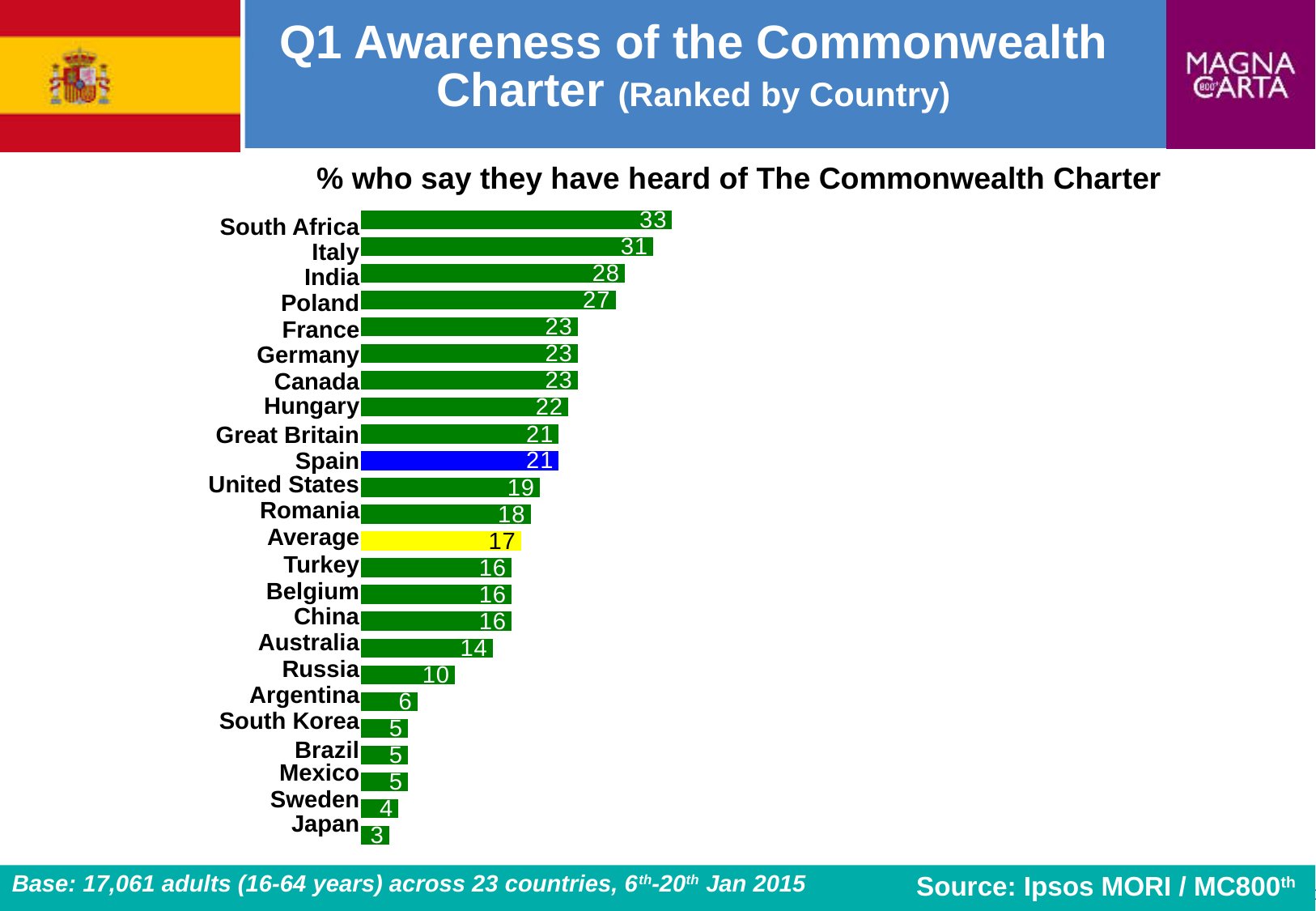
What is the value for South Africa? 33 Which has a larger value, Poland or Hungary? Poland What is the value shown for Average? 17 How many bars are plotted in the chart, including Average? 24 What is the difference between the values for Italy and India? 3 What is the value for Russia? 10 What is the value for Spain? 21 Which country has the highest value? South Africa Which country has the lowest value? Japan What kind of chart is shown on the slide? Bar chart Which bar is coloured blue? Spain What is the difference between the values for South Africa and Japan? 30